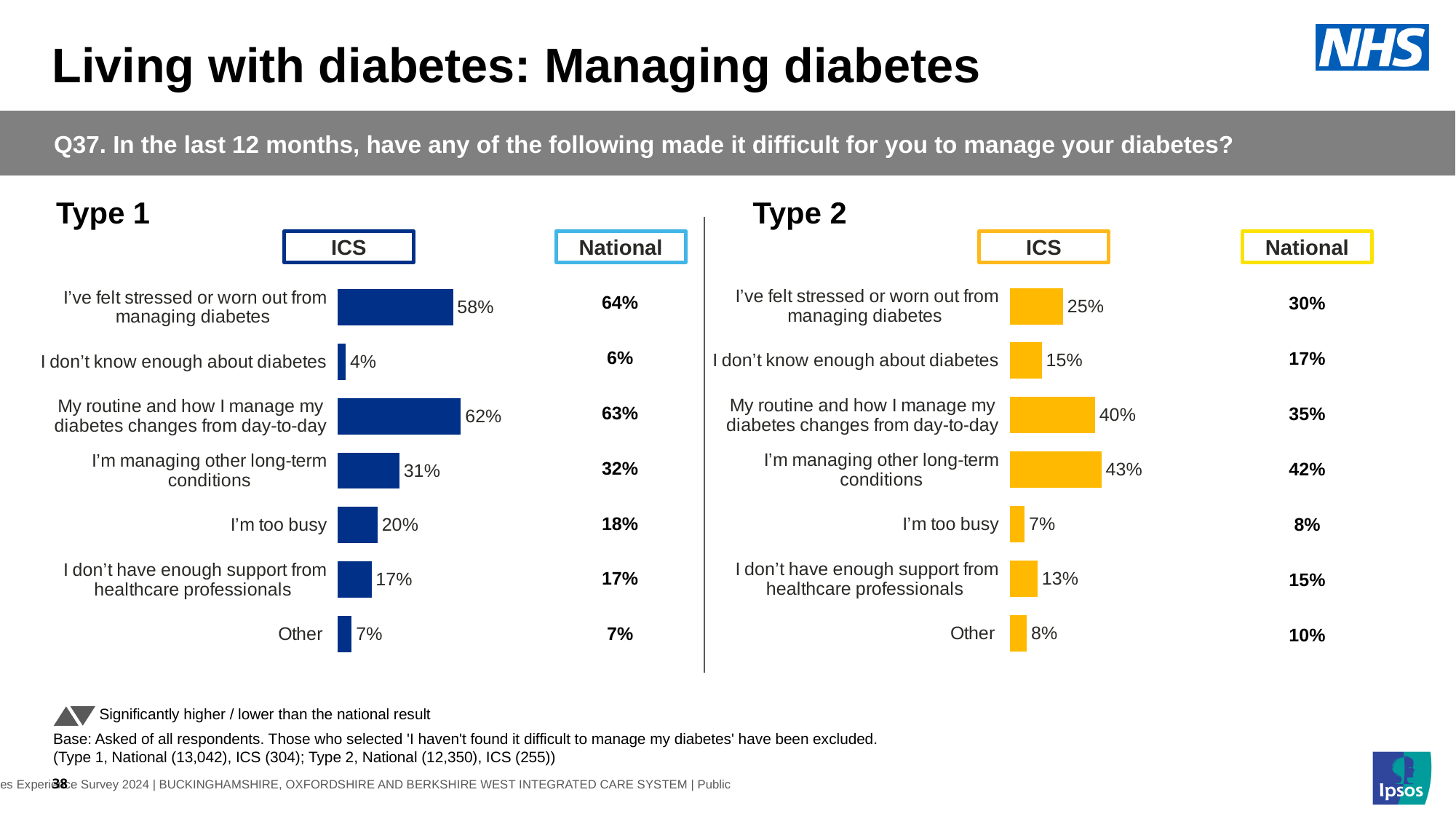
In the Type 2 chart, what is the difference between the ICS values for "I'm managing other long-term conditions" and "I'm too busy"? 36 percentage points In the Type 1 chart, what is the National value for "I've felt stressed or worn out from managing diabetes"? 64% In the Type 1 chart, what is the difference between the ICS and National values for "I've felt stressed or worn out from managing diabetes"? 6 percentage points In the Type 2 chart, which is larger for "My routine and how I manage my diabetes changes from day-to-day": the ICS value or the National value? ICS In the Type 2 chart, what is the ICS value for "I'm managing other long-term conditions"? 43% What colour are the ICS bars in the Type 2 chart? Yellow In the Type 1 chart, how many categories are shown? 7 In the Type 1 chart, which category has the highest ICS value? My routine and how I manage my diabetes changes from day-to-day What type of chart is used for the ICS values in the Type 1 chart? Bar chart In the Type 1 chart, what is the ICS value for "I'm too busy"? 20% In the Type 2 chart, what is the National value for "Other"? 10% In the Type 2 chart, which category has the lowest ICS value? I'm too busy